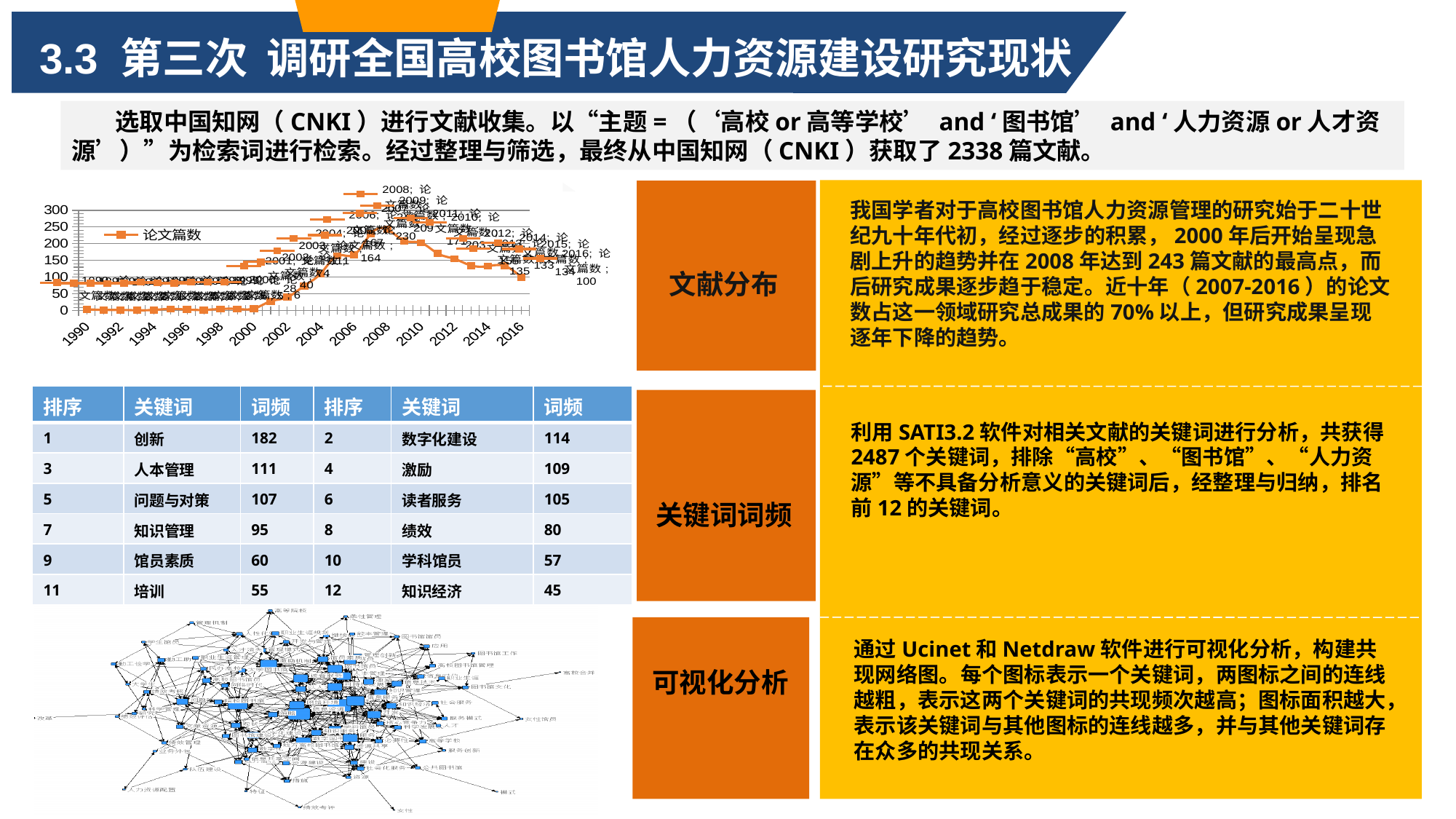
In the line chart, what is the difference between the 论文篇数 values for 2009 and 2010? 6 In the line chart, what is the value of 论文篇数 for 2009? 209 In the line chart, what is the value of 论文篇数 for 2013? 135 In the line chart, what is the value of 论文篇数 for 2016? 100 What is the name of the series plotted in the line chart? 论文篇数 In the line chart, what is the value of 论文篇数 for 2010? 203 In the line chart, which is larger: the 论文篇数 value for 2009 or for 2016? 2009 How many series does the legend of the line chart list? 1 In the line chart, do the 论文篇数 values rise or fall from 2010 to 2016? fall In the line chart, which year has the highest number of 论文篇数? 2008 What kind of chart is shown at the top left of the slide? line chart In the line chart, is the value for 2008 greater or less than 200? greater